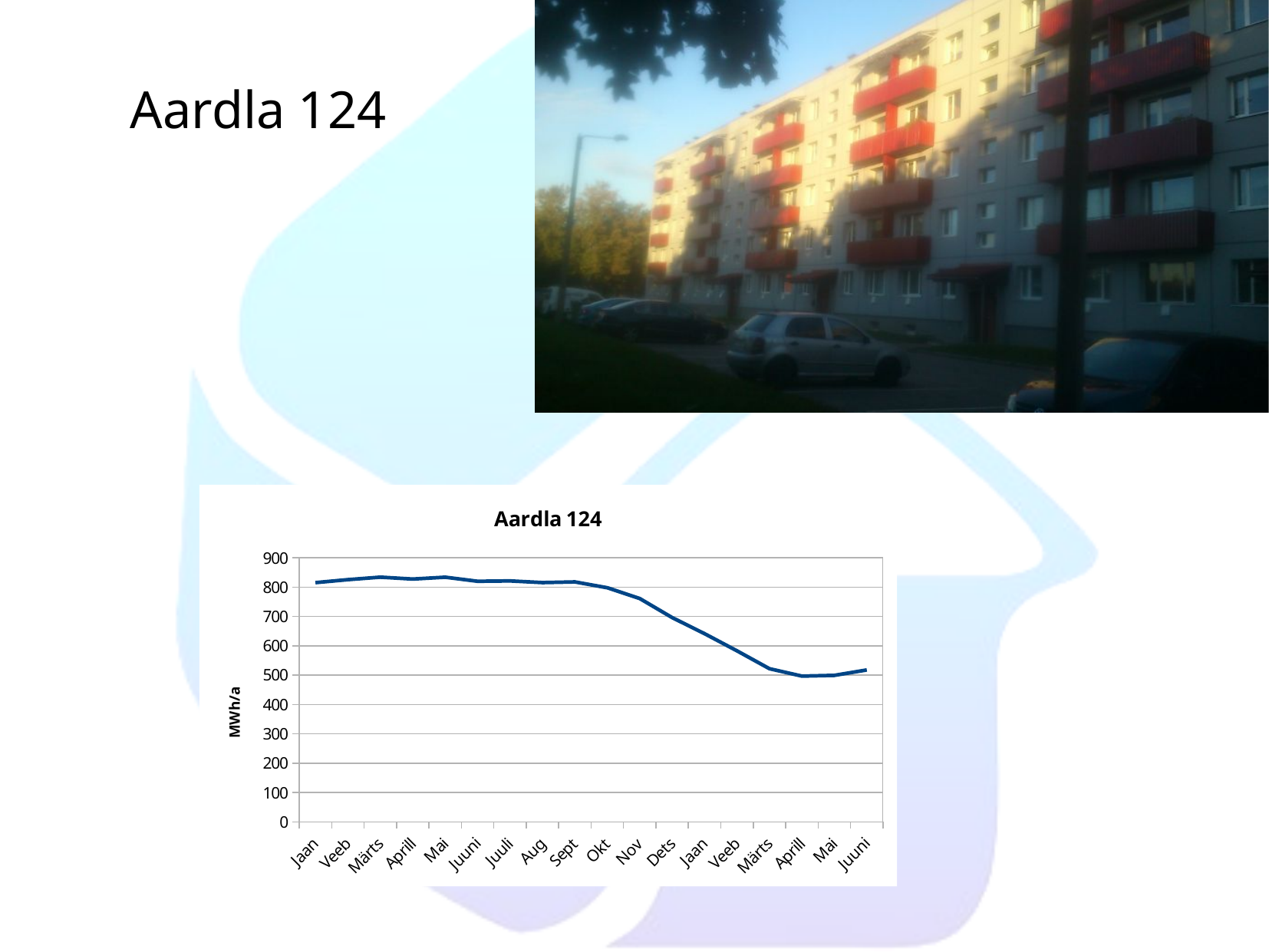
Is the value for the second Jaan greater or less than 600? greater What kind of chart is shown on the slide? line chart Is the value for Nov greater or less than 800? less Which is larger, the value for the first Jaan or the value for the second Jaan? the first Jaan Is the value for the second Aprill greater or less than 600? less Which is larger, the value for Aug or the value for Dets? Aug How many data points are plotted along the x axis of the chart? 18 What is the title of the chart? Aardla 124 Does the plotted value generally rise or fall from the first Jaan to the second Aprill? fall What is the label on the vertical axis of the chart? MWh/a